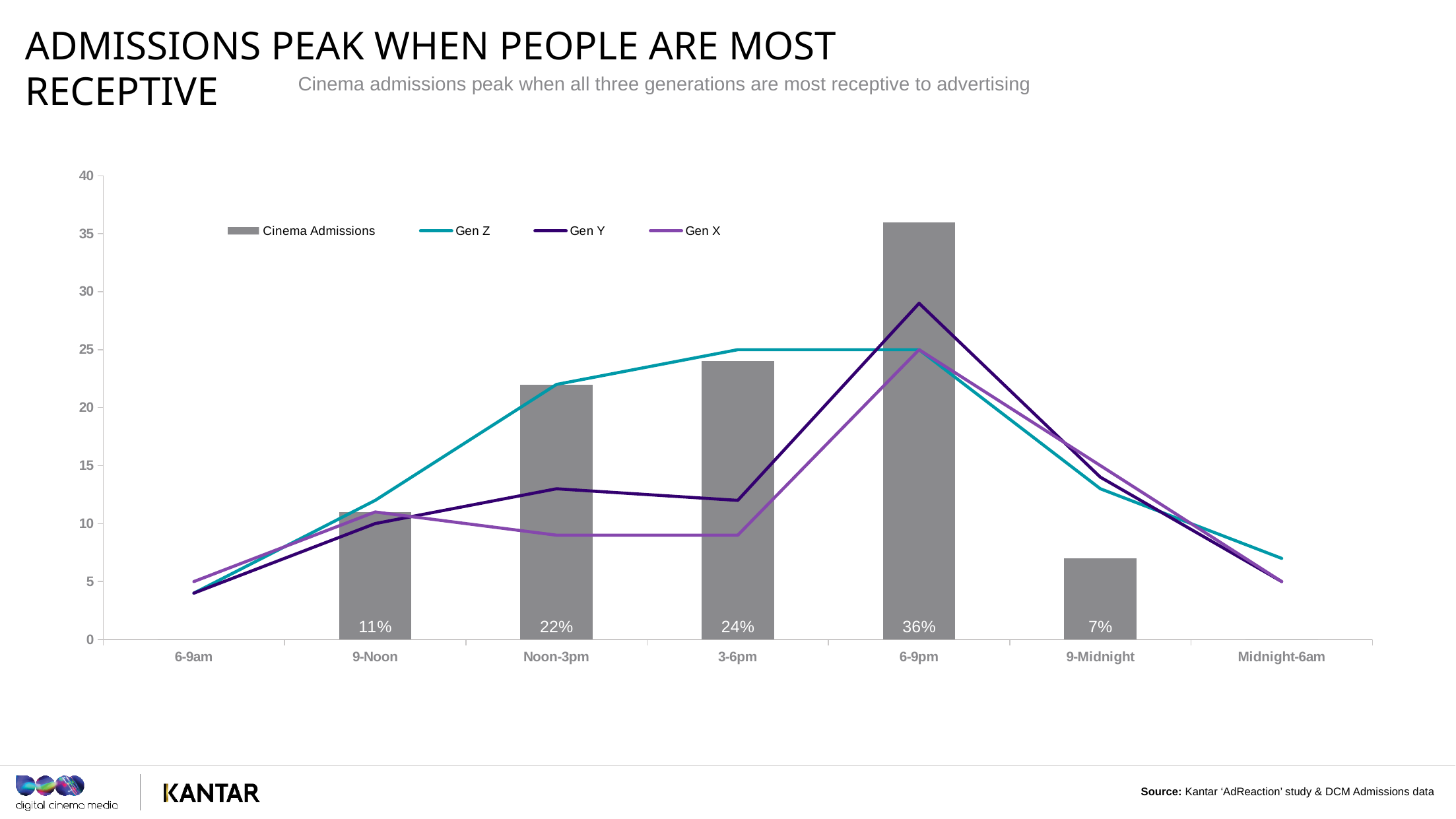
Which time slot has the larger Cinema Admissions value, Noon-3pm or 3-6pm? 3-6pm Is the Gen X value at Noon-3pm greater or less than 10? less What is the Cinema Admissions value for the 9-Midnight time slot? 7% How many time slots are shown on the x axis? 7 What is the Cinema Admissions value for the 6-9pm time slot? 36% Does the Gen Z line rise or fall from 6-9am to 3-6pm? Rise What kind of chart is shown on the slide? Combination bar and line chart Which time slot has the highest Cinema Admissions bar? 6-9pm Which time slot has the lowest labelled Cinema Admissions bar? 9-Midnight What is the difference between the Cinema Admissions values for 6-9pm and 3-6pm? 12% How many series does the legend list? 4 Is the Gen Y value at 6-9pm greater or less than 25? greater